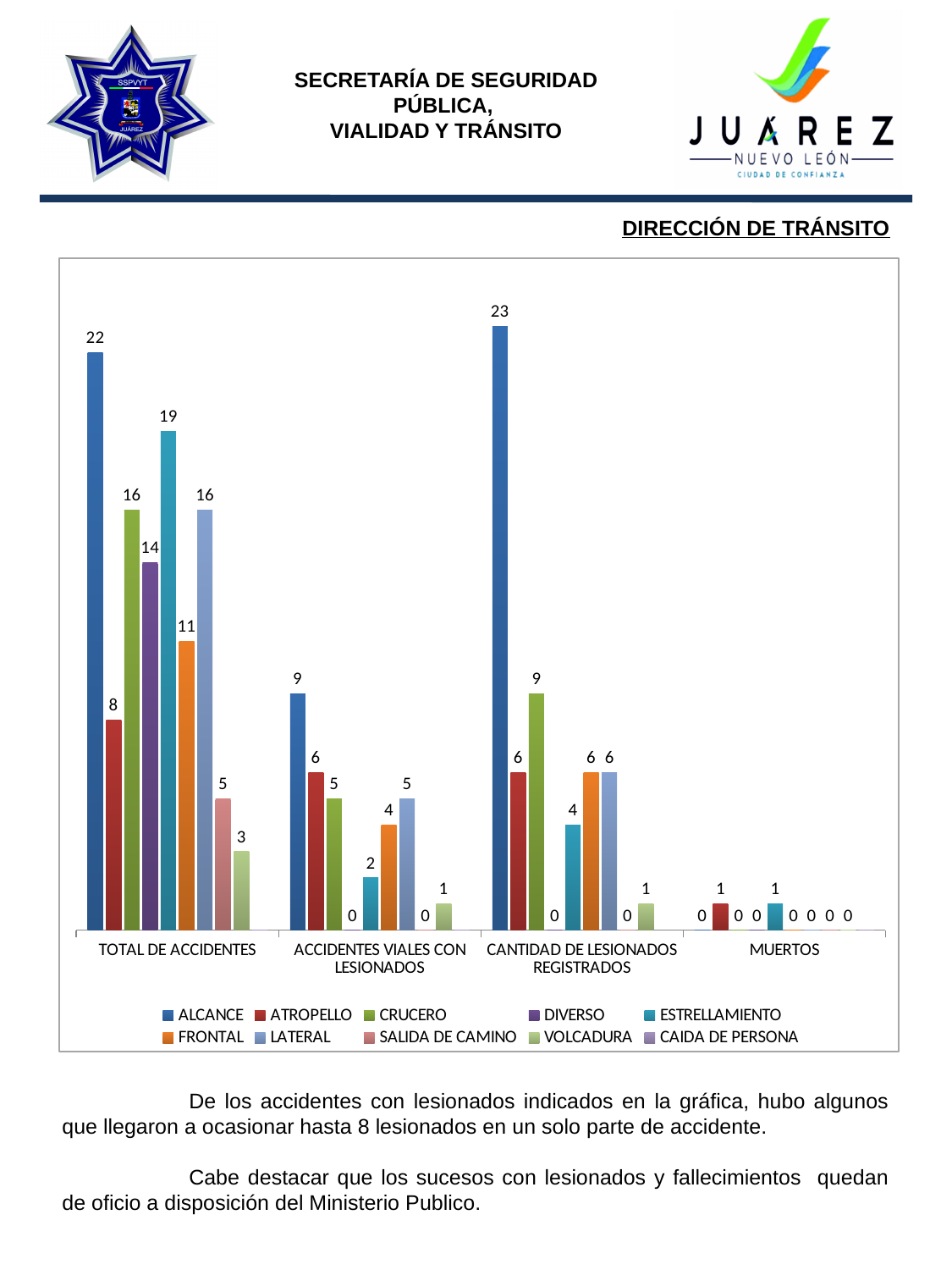
What is the value for ATROPELLO in the MUERTOS category? 1 What is the difference between ALCANCE and ATROPELLO in the TOTAL DE ACCIDENTES category? 14 How many series does the legend list? 10 In the CANTIDAD DE LESIONADOS REGISTRADOS category, which is larger: CRUCERO or ESTRELLAMIENTO? CRUCERO What kind of chart is shown on the slide? Bar chart What is the value for ALCANCE in the CANTIDAD DE LESIONADOS REGISTRADOS category? 23 What is the value for FRONTAL in the ACCIDENTES VIALES CON LESIONADOS category? 4 Which series has the highest value in the ACCIDENTES VIALES CON LESIONADOS category? ALCANCE What is the value for ESTRELLAMIENTO in the TOTAL DE ACCIDENTES category? 19 How many categories are shown on the x axis? 4 Which series has the lowest labelled value in the TOTAL DE ACCIDENTES category? VOLCADURA What is the value for ALCANCE in the TOTAL DE ACCIDENTES category? 22